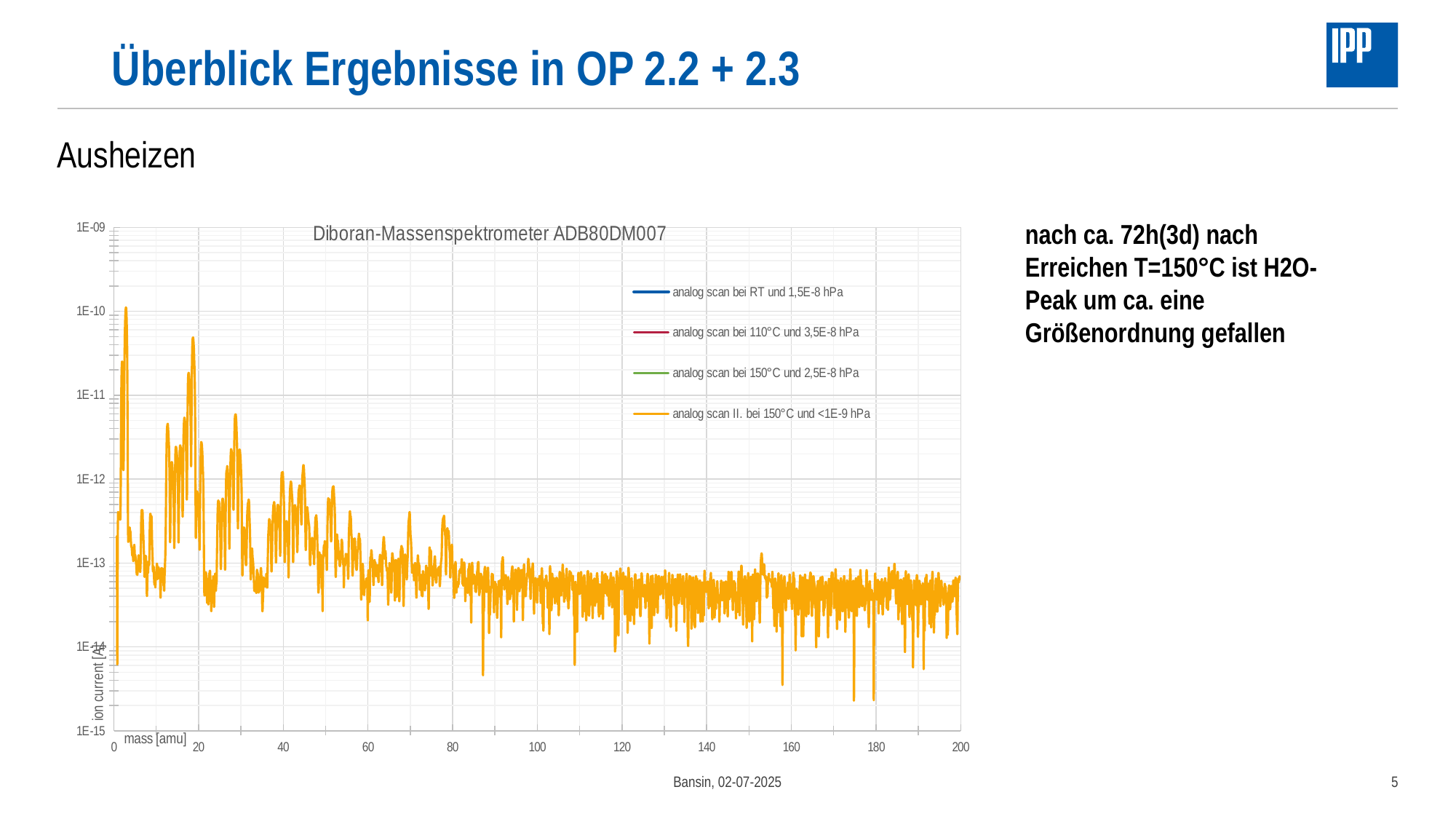
What is the highest tick value shown on the y axis? 1E-09 What is the highest tick value shown on the x axis? 200 What kind of chart is shown on the slide? line chart What is the title of the chart? Diboran-Massenspektrometer ADB80DM007 Which series in the legend is drawn in orange? analog scan II. bei 150°C und <1E-9 hPa Is the peak of the orange series near mass 18 amu greater or less than 1E-11? greater Is the orange series at mass 100 amu greater or less than 1E-12? less How many series does the chart's legend list? 4 What is the label of the x axis of the chart? mass [amu] Is the peak of the orange series near mass 18 amu greater or less than 1E-10? less What is the lowest tick value shown on the y axis? 1E-15 Do the values of the orange series generally rise or fall as mass increases from 0 to 200 amu? fall